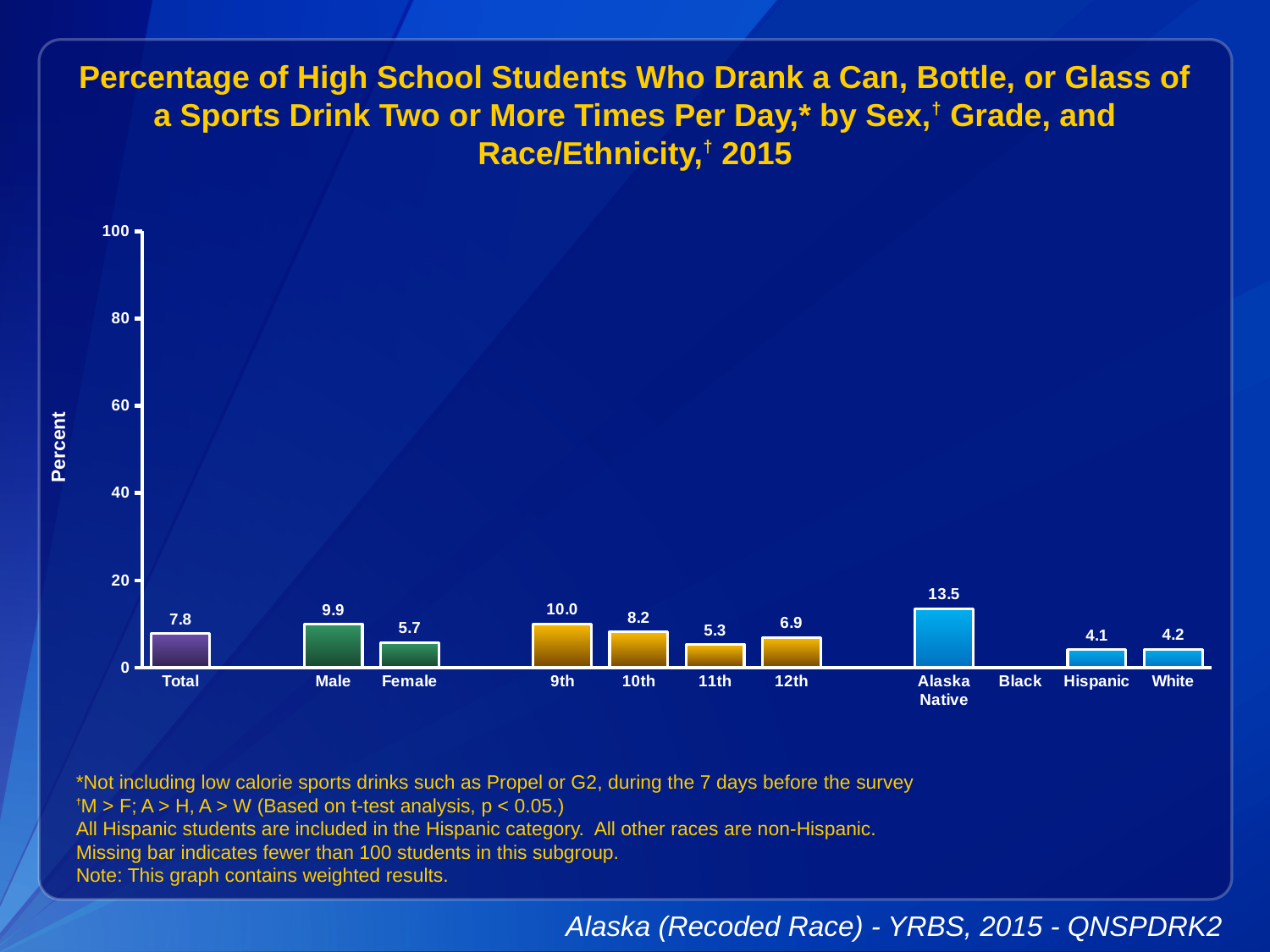
What is the value for Total? 7.8 What is the value for Alaska Native? 13.5 Which category has no bar shown? Black Which category with a plotted bar has the lowest value? Hispanic Which category has the highest value? Alaska Native Which is larger, the value for 9th grade or the value for 12th grade? 9th How many categories have a bar plotted? 10 What is the value for 11th grade? 5.3 What kind of chart is shown? bar chart What is the difference between the Male and Female values? 4.2 Is the value for Alaska Native greater or less than 20? less What is the value for Male? 9.9